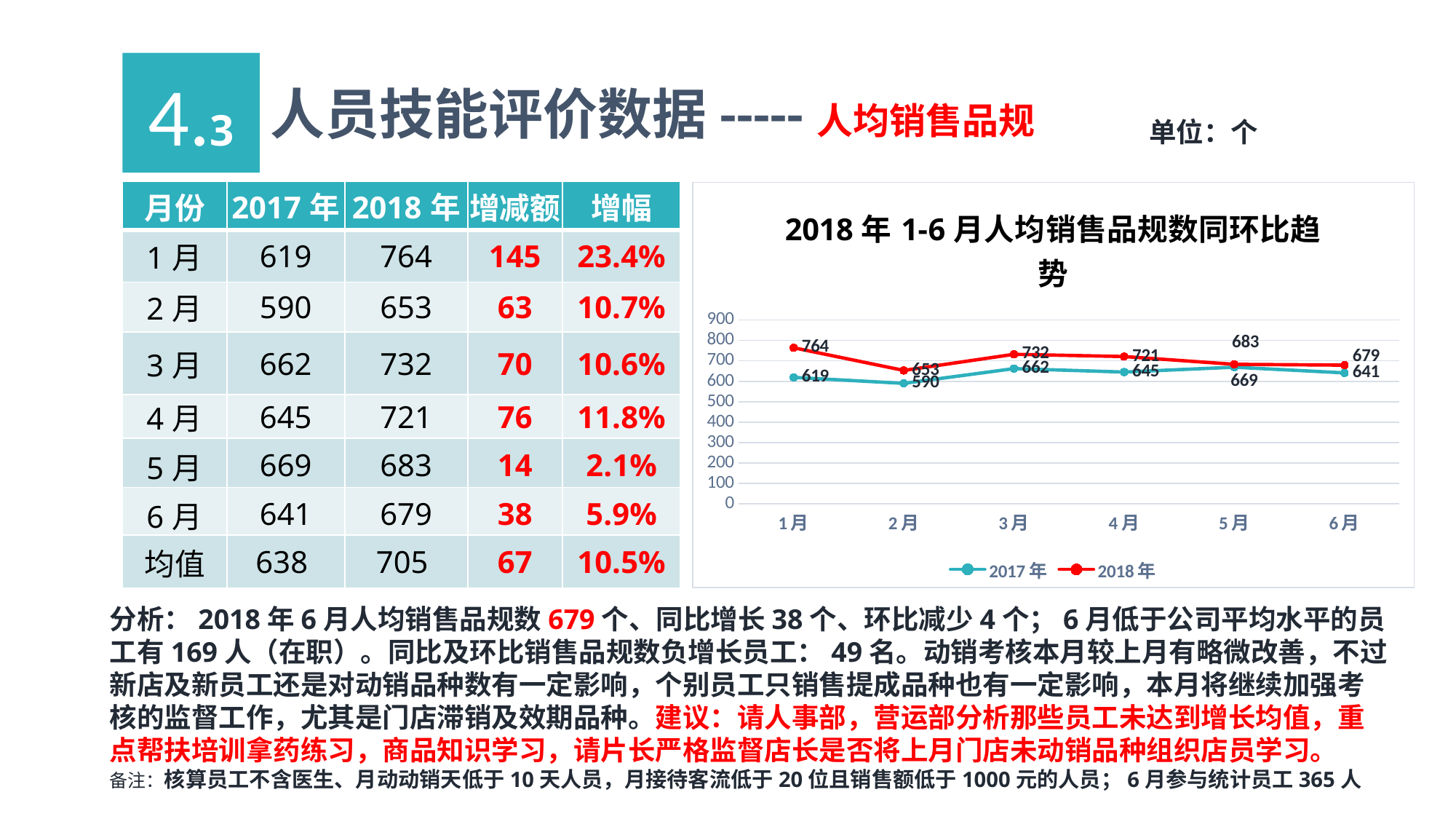
In which month is the 2018年 series highest? 1月 Which is larger in 3月, the 2017年 value or the 2018年 value? 2018年 What is the value for 2018年 in 1月? 764 How many months are plotted on the x axis? 6 Does the 2018年 series rise or fall from 1月 to 2月? fall What is the difference between the 2018年 and 2017年 values in 1月? 145 How many series does the chart legend list? 2 What is the title of the chart? 2018年1-6月人均销售品规数同环比趋势 What is the value for 2017年 in 5月? 669 In which month is the 2017年 series lowest? 2月 What type of chart is shown on the slide? line chart What is the value for 2018年 in 6月? 679